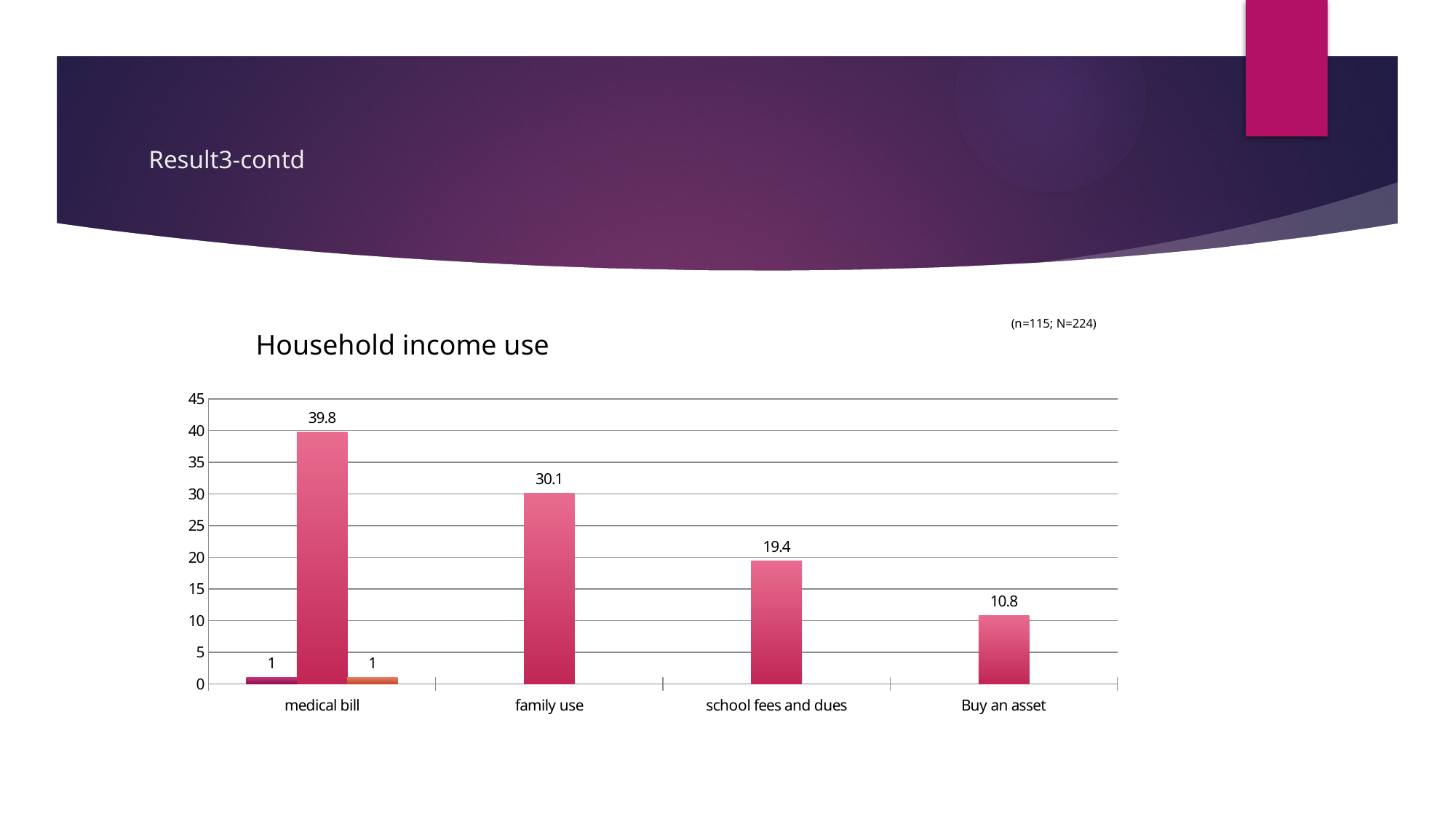
What is the difference between the values for family use and Buy an asset? 19.3 What is the value for school fees and dues? 19.4 What kind of chart is shown on the slide? bar chart What is the value of the tall pink bar for medical bill? 39.8 Which category has the highest value? medical bill What is the difference between the tall medical bill bar (39.8) and school fees and dues? 20.4 Which is larger, the value for family use or the value for school fees and dues? family use How many categories are labelled on the x axis? 4 What is the value for Buy an asset? 10.8 Which of the four labelled categories has the lowest main bar value? Buy an asset What is the title of the chart? Household income use What is the value for family use? 30.1